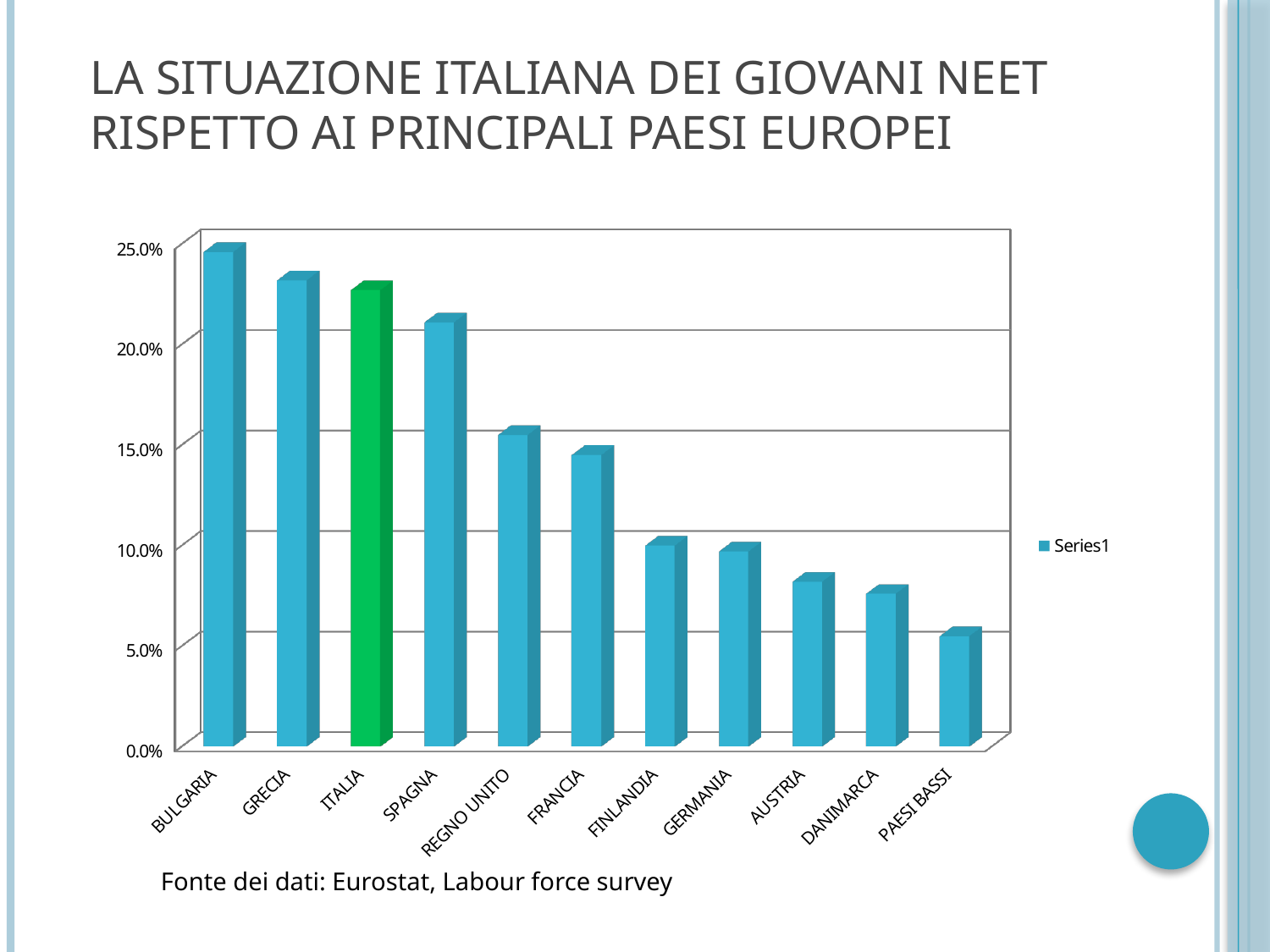
Is the value for REGNO UNITO greater or less than 20.0%? less Which has the larger value, BULGARIA or GRECIA? BULGARIA Do the values rise or fall moving from left to right along the x axis? fall Which has the larger value, SPAGNA or REGNO UNITO? SPAGNA Which country's bar is coloured green instead of blue? ITALIA Is the value for AUSTRIA greater or less than 10.0%? less How many series does the chart legend list? 1 Which country has the lowest value in the chart? PAESI BASSI Is the value for ITALIA greater or less than 20.0%? greater Which country has the highest value in the chart? BULGARIA What kind of chart is shown on the slide? bar chart How many countries are shown on the x axis of the chart? 11